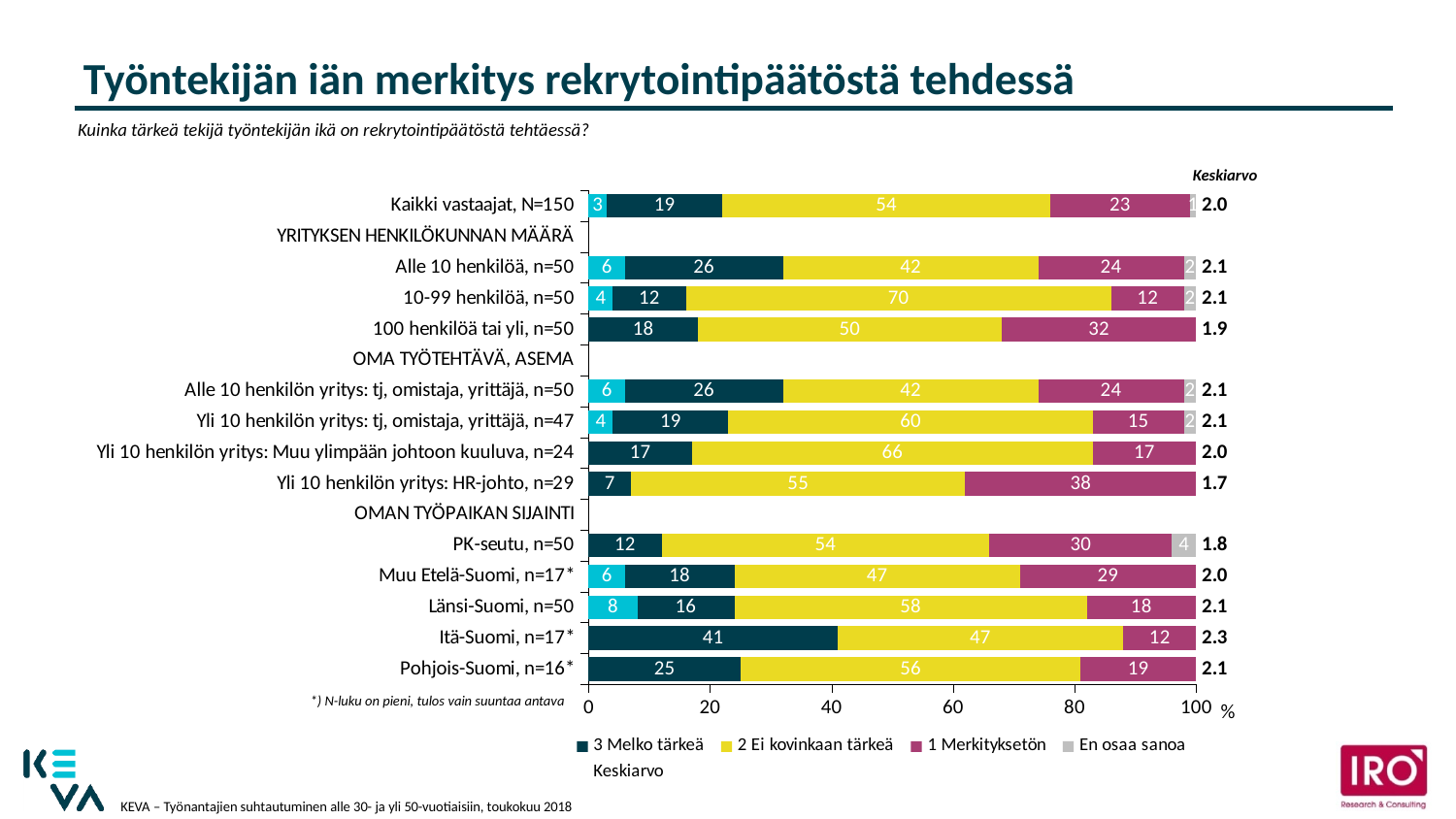
Which row has the highest Keskiarvo value? Itä-Suomi, n=17* Which row has the highest "3 Melko tärkeä" value? Itä-Suomi, n=17* What is the value of the "2 Ei kovinkaan tärkeä" segment for "10-99 henkilöä, n=50"? 70 Which row has the lowest Keskiarvo value? Yli 10 henkilön yritys: HR-johto, n=29 What is the total of the stacked bar for "100 henkilöä tai yli, n=50"? 100 What is the difference between the "3 Melko tärkeä" values for "Itä-Suomi, n=17*" and "Pohjois-Suomi, n=16*"? 16 What is the value of the "2 Ei kovinkaan tärkeä" segment for "Kaikki vastaajat, N=150"? 54 Which has a larger "1 Merkityksetön" value: "PK-seutu, n=50" or "Länsi-Suomi, n=50"? PK-seutu, n=50 What is the Keskiarvo shown for "Itä-Suomi, n=17*"? 2.3 What kind of chart is shown on the slide? Stacked horizontal bar chart What is the value of the "1 Merkityksetön" segment for "Yli 10 henkilön yritys: HR-johto, n=29"? 38 How many bars (respondent groups) are plotted in the chart? 13